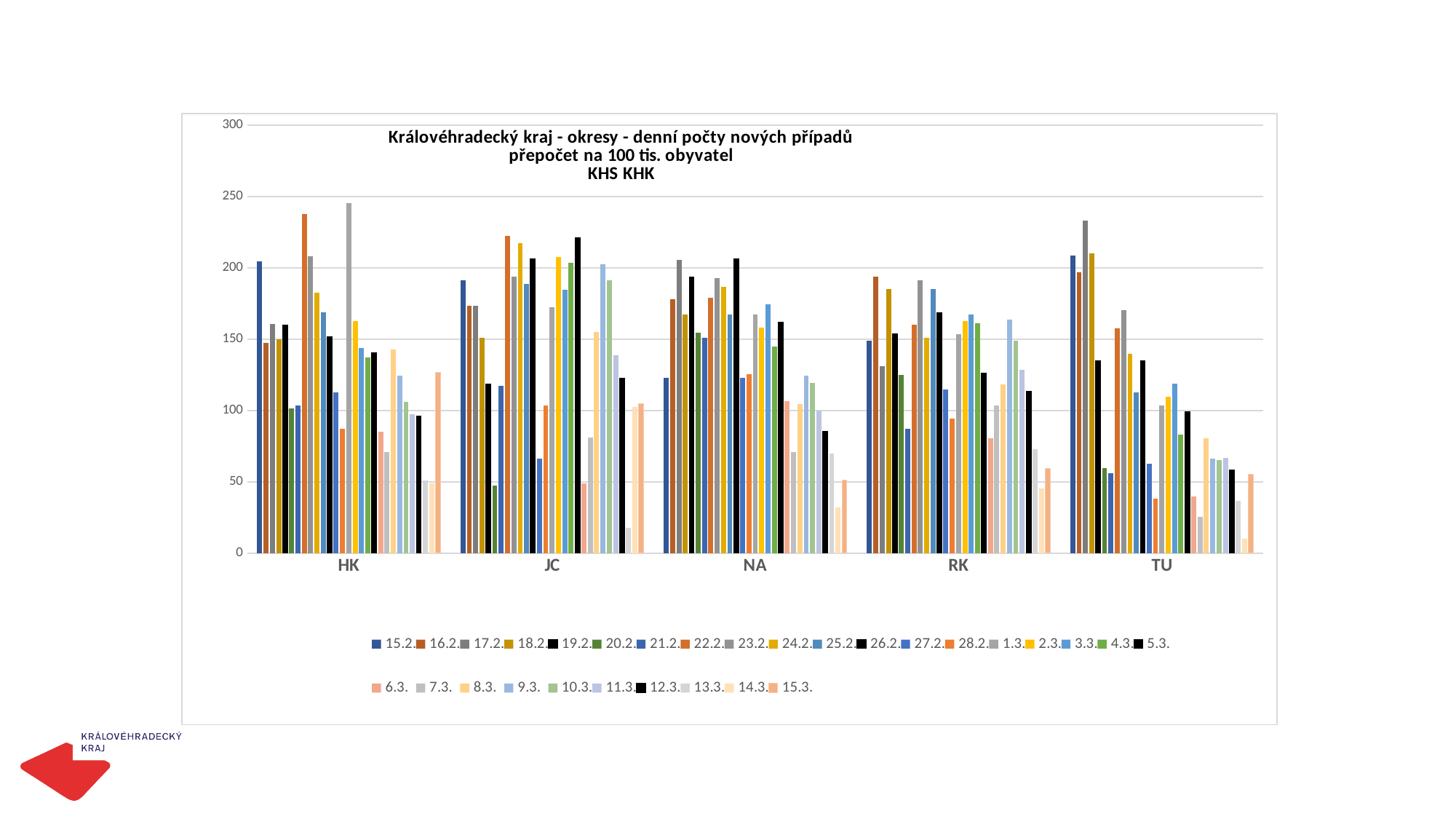
What is the highest value shown on the y axis? 300 Is the value for 13.3. in JC greater or less than 50? less Which is larger, the value for 16.2. in HK or the value for 16.2. in JC? JC How many series (dates) does the legend list? 29 Is the value for 15.2. in NA greater or less than 100? greater Is the value for 15.2. in HK greater or less than 200? greater What is the title of the chart? Královéhradecký kraj - okresy - denní počty nových případů přepočet na 100 tis. obyvatel KHS KHK What kind of chart is shown on the slide? bar chart How many district categories are shown on the x axis? 5 Which district has the lowest value for 15.2.? NA